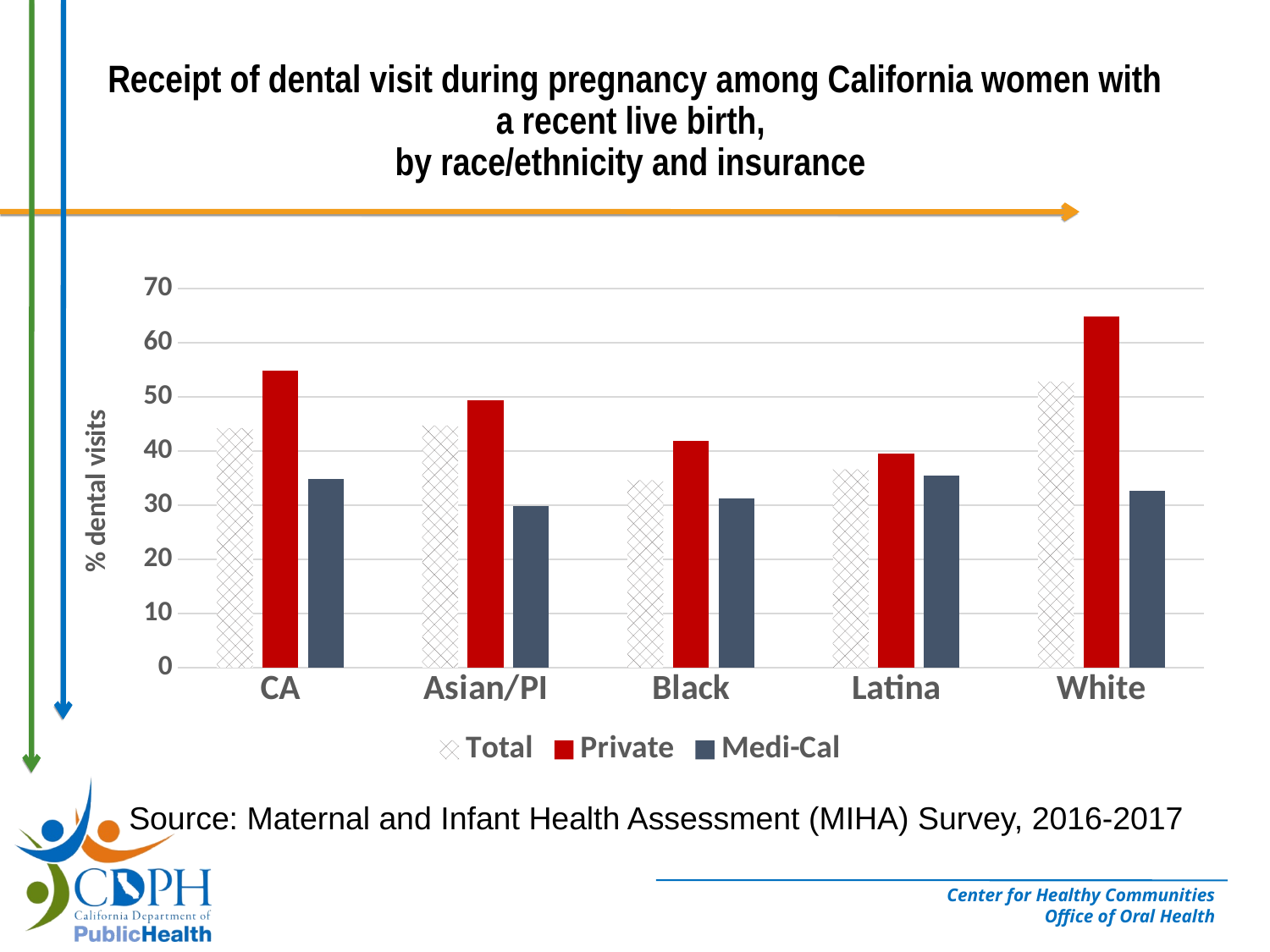
How many race/ethnicity categories are shown on the x axis? 5 Which category has the highest Private value? White Is the Private value for White greater or less than 60? greater Which is larger: the Private value for White or the Private value for Asian/PI? White Is the Private value for CA greater or less than 50? greater What is the label on the y axis? % dental visits Is the Total value for Black greater or less than 40? less Which category has the highest Total value? White What kind of chart is shown on the slide? bar chart For CA, which is larger: the Private value or the Medi-Cal value? Private How many series does the legend list? 3